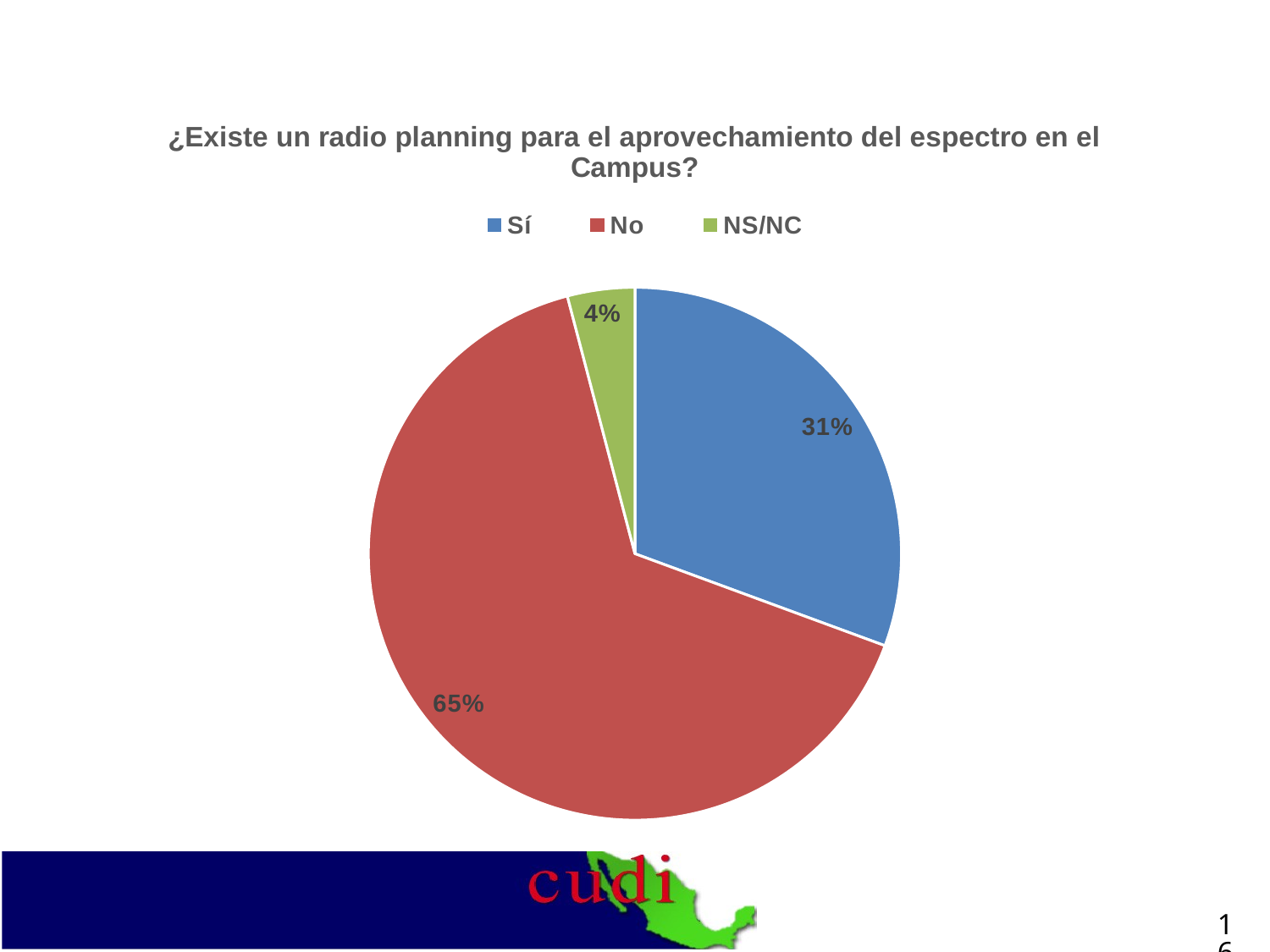
How many slices does the pie chart have? 3 What colour is the "No" slice? red Which response has the smallest share of the pie? NS/NC What percentage of responses are "NS/NC"? 4% What is the title of the chart? ¿Existe un radio planning para el aprovechamiento del espectro en el Campus? Which response has the largest share of the pie? No What percentage of responses are "Sí"? 31% What percentage of responses are "No"? 65% What kind of chart is shown on the slide? pie chart What is the difference in percentage points between the "No" and "Sí" slices? 34 How many entries does the legend list? 3 Which slice is larger, "Sí" or "NS/NC"? Sí